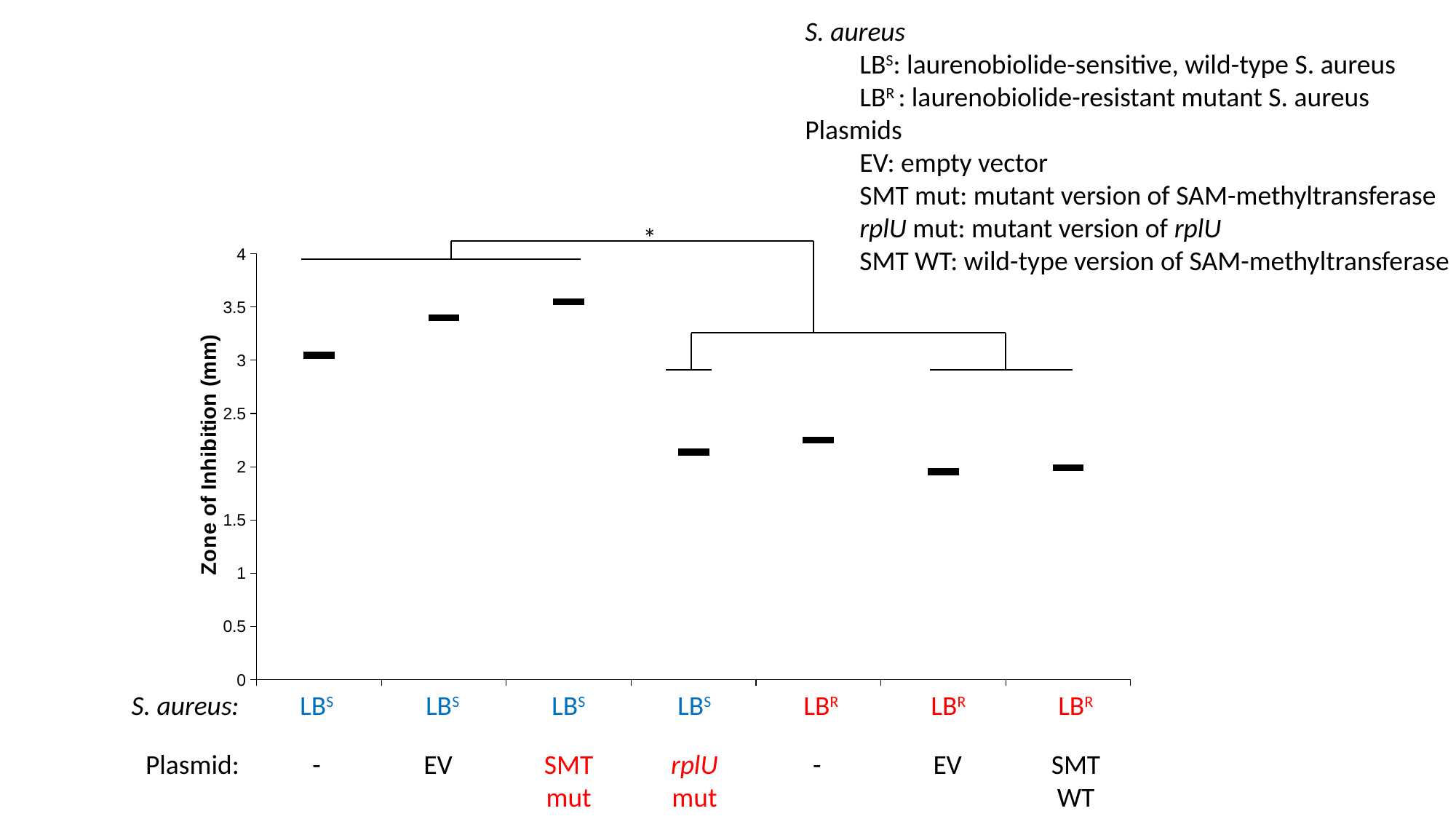
Which condition has the highest zone of inhibition? LBS with SMT mut Is the zone of inhibition for LBS with no plasmid (-) greater or less than 2.5 mm? greater What kind of chart is shown on the slide? scatter chart Is the zone of inhibition for LBS with EV greater or less than 3 mm? greater Which has a larger zone of inhibition: LBS with EV or LBR with EV? LBS with EV What is the y-axis title of the chart? Zone of Inhibition (mm) Which has a larger zone of inhibition: LBS with no plasmid (-) or LBS with rplU mut? LBS with no plasmid (-) Is the zone of inhibition for LBR with SMT WT greater or less than 3 mm? less What is the maximum value shown on the y-axis? 4 How many data points are plotted in the chart? 7